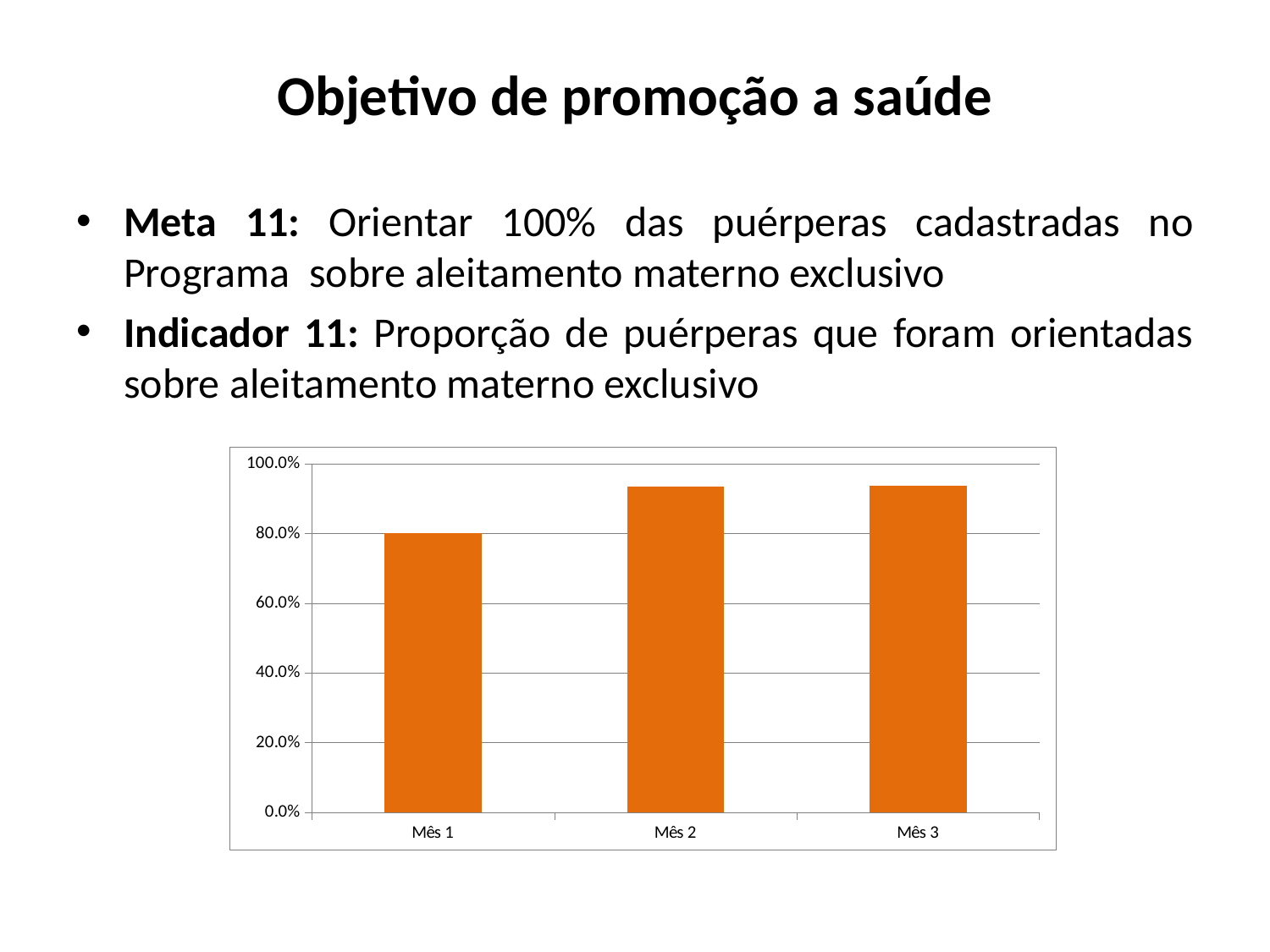
Which is larger in the chart, the value for Mês 1 or the value for Mês 2? Mês 2 What is the highest value shown on the y axis of the chart? 100.0% Which is larger in the chart, the value for Mês 3 or the value for Mês 1? Mês 3 Is the value for Mês 2 greater or less than 80.0%? greater Is the value for Mês 1 greater or less than 60.0%? greater What type of chart is shown on the slide? bar chart How many categories (months) are shown on the x axis of the chart? 3 What colour are the bars in the chart? orange Which month has the lowest value in the chart? Mês 1 Is the value for Mês 3 greater or less than 100.0%? less Do the values rise or fall from Mês 1 to Mês 2? rise What is the value for Mês 1 in the chart? 80.0%